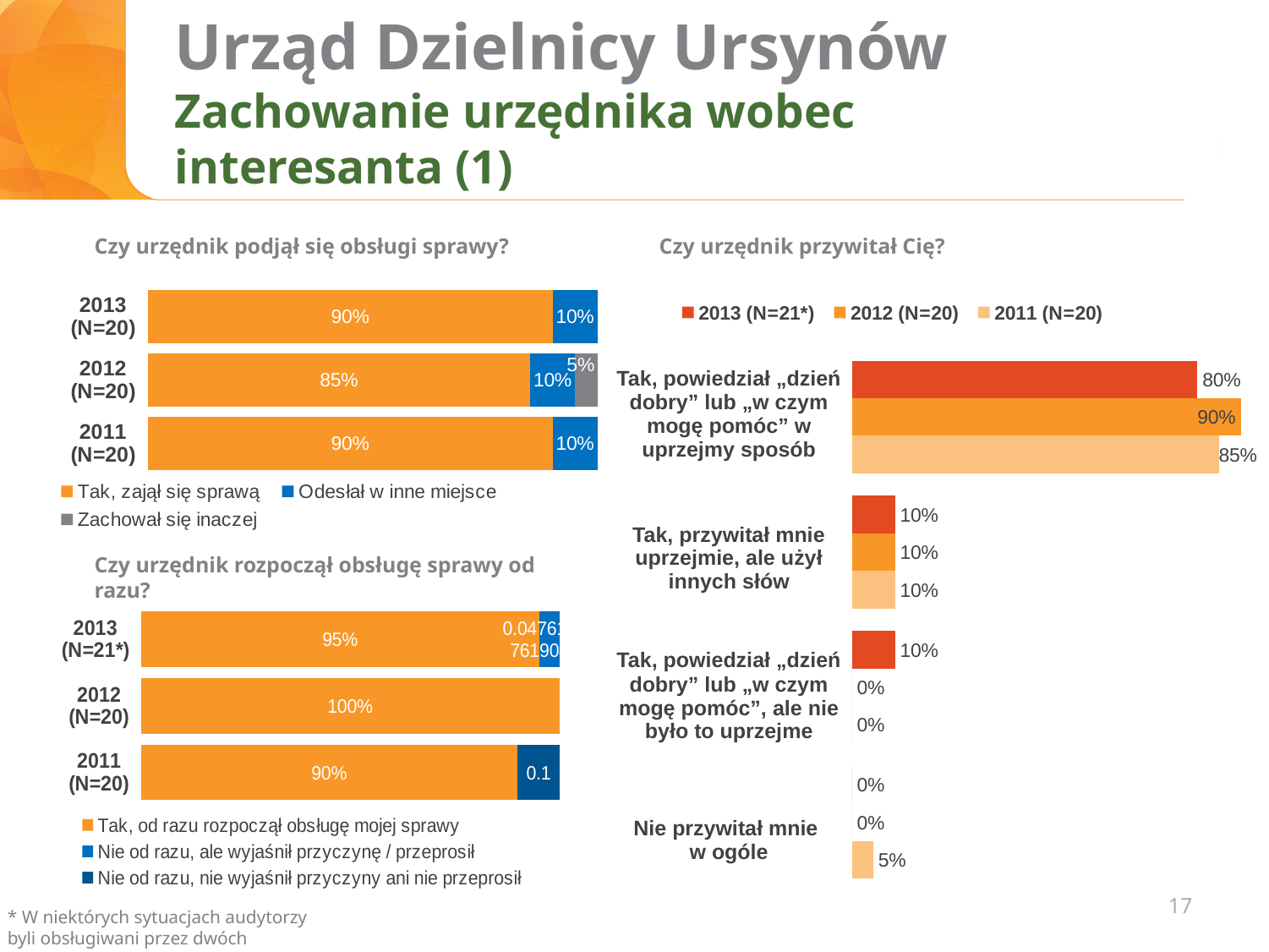
In the chart "Czy urzędnik podjął się obsługi sprawy?", what is the difference between the "Tak, zajął się sprawą" values for 2013 (N=20) and 2012 (N=20)? 5% In the chart "Czy urzędnik przywitał Cię?", which year has the highest value in the category "Tak, powiedział „dzień dobry” lub „w czym mogę pomóc” w uprzejmy sposób"? 2012 (N=20) In the chart "Czy urzędnik rozpoczął obsługę sprawy od razu?", which year has the lowest value for "Tak, od razu rozpoczął obsługę mojej sprawy"? 2011 (N=20) In the chart "Czy urzędnik przywitał Cię?", what is the value for 2012 (N=20) in the category "Tak, powiedział „dzień dobry” lub „w czym mogę pomóc” w uprzejmy sposób"? 90% In the chart "Czy urzędnik podjął się obsługi sprawy?", what is the value for "Tak, zajął się sprawą" in 2012 (N=20)? 85% In the chart "Czy urzędnik przywitał Cię?", what is the value for 2011 (N=20) in the category "Nie przywitał mnie w ogóle"? 5% In the chart "Czy urzędnik podjął się obsługi sprawy?", what is the value for "Zachował się inaczej" in 2012 (N=20)? 5% What kind of chart is "Czy urzędnik przywitał Cię?"? Bar chart In the chart "Czy urzędnik rozpoczął obsługę sprawy od razu?", how many year categories are shown? 3 In the chart "Czy urzędnik rozpoczął obsługę sprawy od razu?", what is the value for "Tak, od razu rozpoczął obsługę mojej sprawy" in 2012 (N=20)? 100% In the chart "Czy urzędnik podjął się obsługi sprawy?", how many series does the legend list? 3 In the chart "Czy urzędnik przywitał Cię?", how many categories are shown on the vertical axis? 4